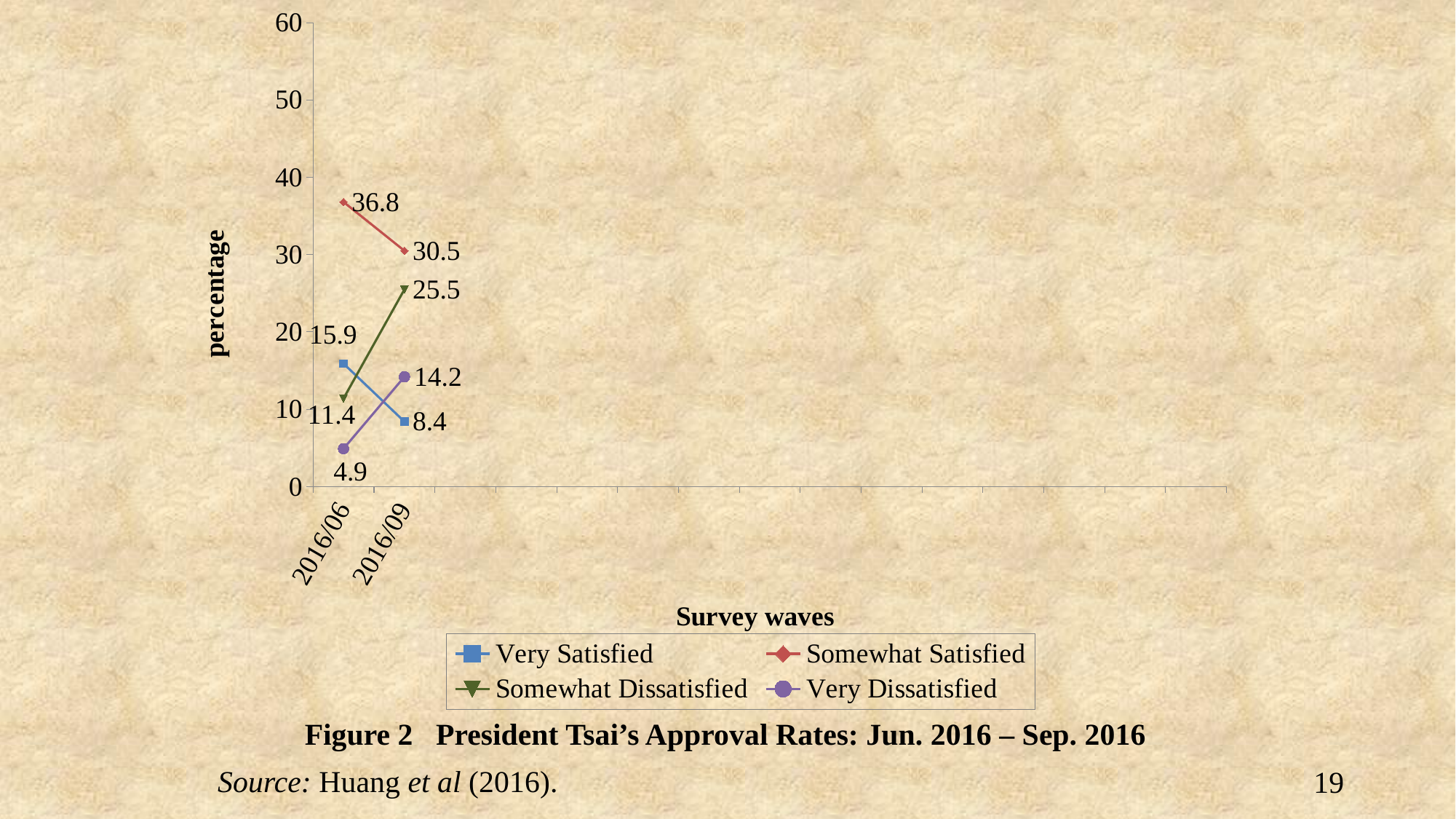
Which series has the highest value in 2016/09? Somewhat Satisfied What type of chart is shown on the slide? line chart What is the value for Very Dissatisfied in 2016/09? 14.2 What is the label of the x axis? Survey waves How many series does the legend list? 4 What is the value for Somewhat Satisfied in 2016/06? 36.8 What is the value for Very Satisfied in 2016/06? 15.9 Which series has the lowest value in 2016/06? Very Dissatisfied By how much did the Very Satisfied value change from 2016/06 to 2016/09? 7.5 What is the value for Somewhat Dissatisfied in 2016/09? 25.5 Which is larger in 2016/09: Somewhat Dissatisfied or Very Dissatisfied? Somewhat Dissatisfied Does the Somewhat Dissatisfied series rise or fall from 2016/06 to 2016/09? rise